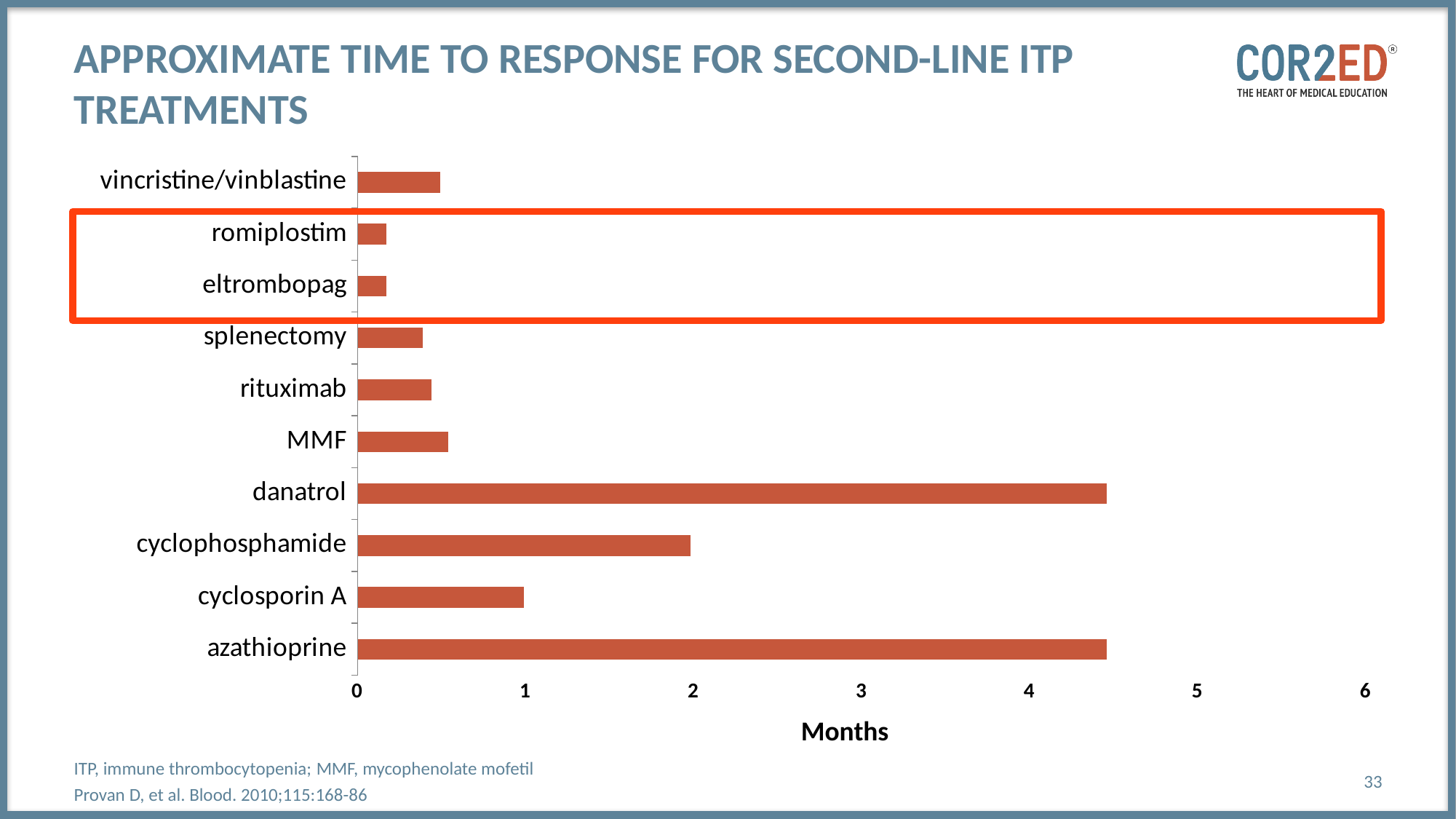
Is the time to response for azathioprine greater or less than 4 months? greater Is the time to response for cyclosporin A greater or less than 2 months? less Is the time to response for cyclophosphamide greater or less than 3 months? less What is the label of the horizontal axis? Months What kind of chart is shown on the slide? Bar chart Which two treatments are enclosed in the red highlight box? romiplostim and eltrombopag How many treatments are listed on the chart? 10 Which has a longer time to response, danatrol or cyclophosphamide? danatrol Which has a longer time to response, cyclosporin A or rituximab? cyclosporin A Which has a longer time to response, cyclophosphamide or splenectomy? cyclophosphamide